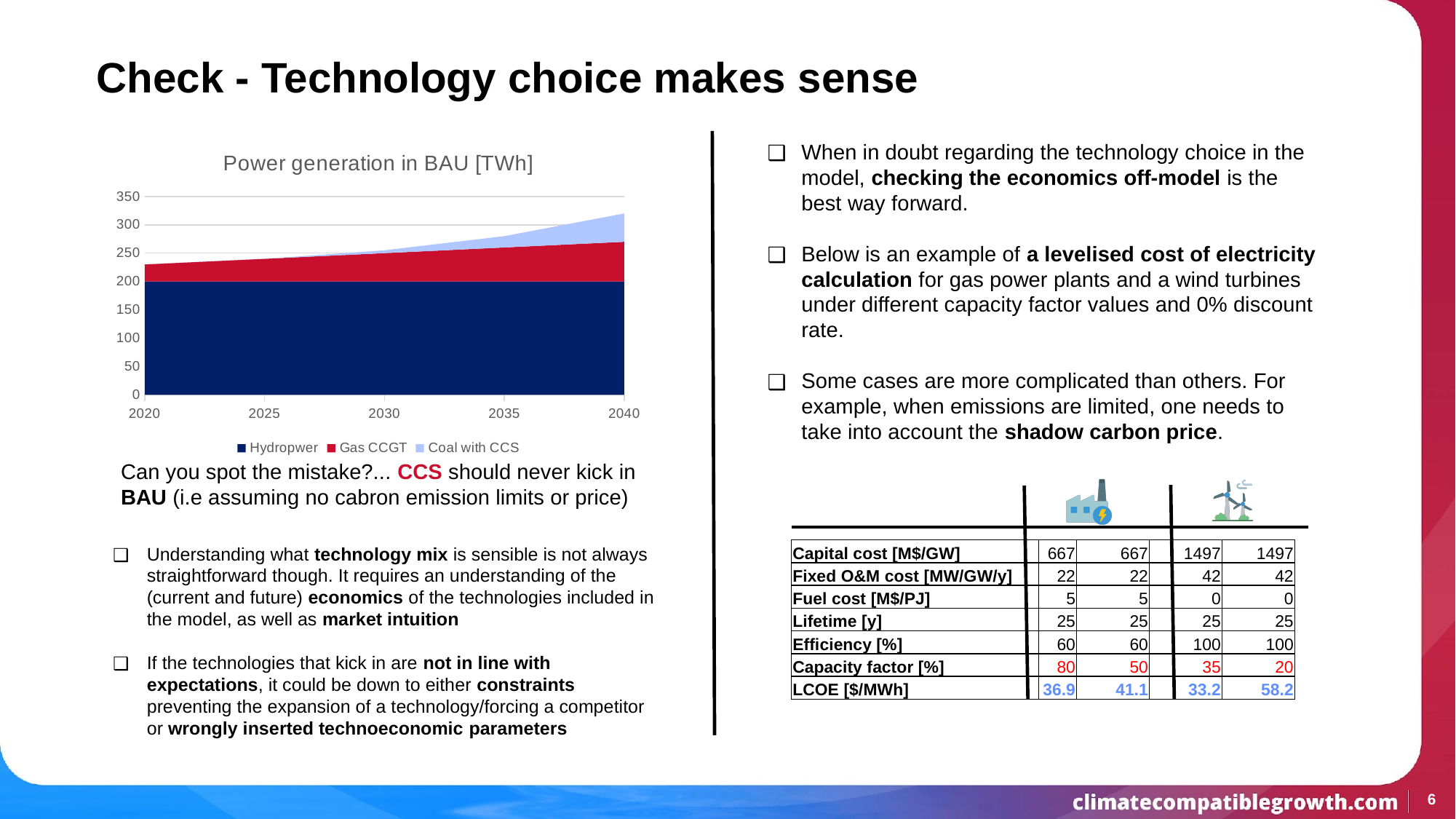
Which series contributes the largest share of power generation across the chart? Hydropwer Is the total power generation in 2020 greater or less than 250? less Is the value for Hydropwer in 2020 greater or less than 150? greater Is the total power generation in 2040 greater or less than 300? greater What type of chart is shown on the slide? Stacked area chart What is the title of the chart on the slide? Power generation in BAU [TWh] Which series contributes the smallest share of power generation across the chart? Coal with CCS How many series does the chart's legend list? 3 Which series are listed in the chart's legend? Hydropwer, Gas CCGT, Coal with CCS Does total power generation rise or fall from 2020 to 2040? Rise What is the highest value shown on the chart's y axis? 350 How many year labels are shown on the x axis of the chart? 5